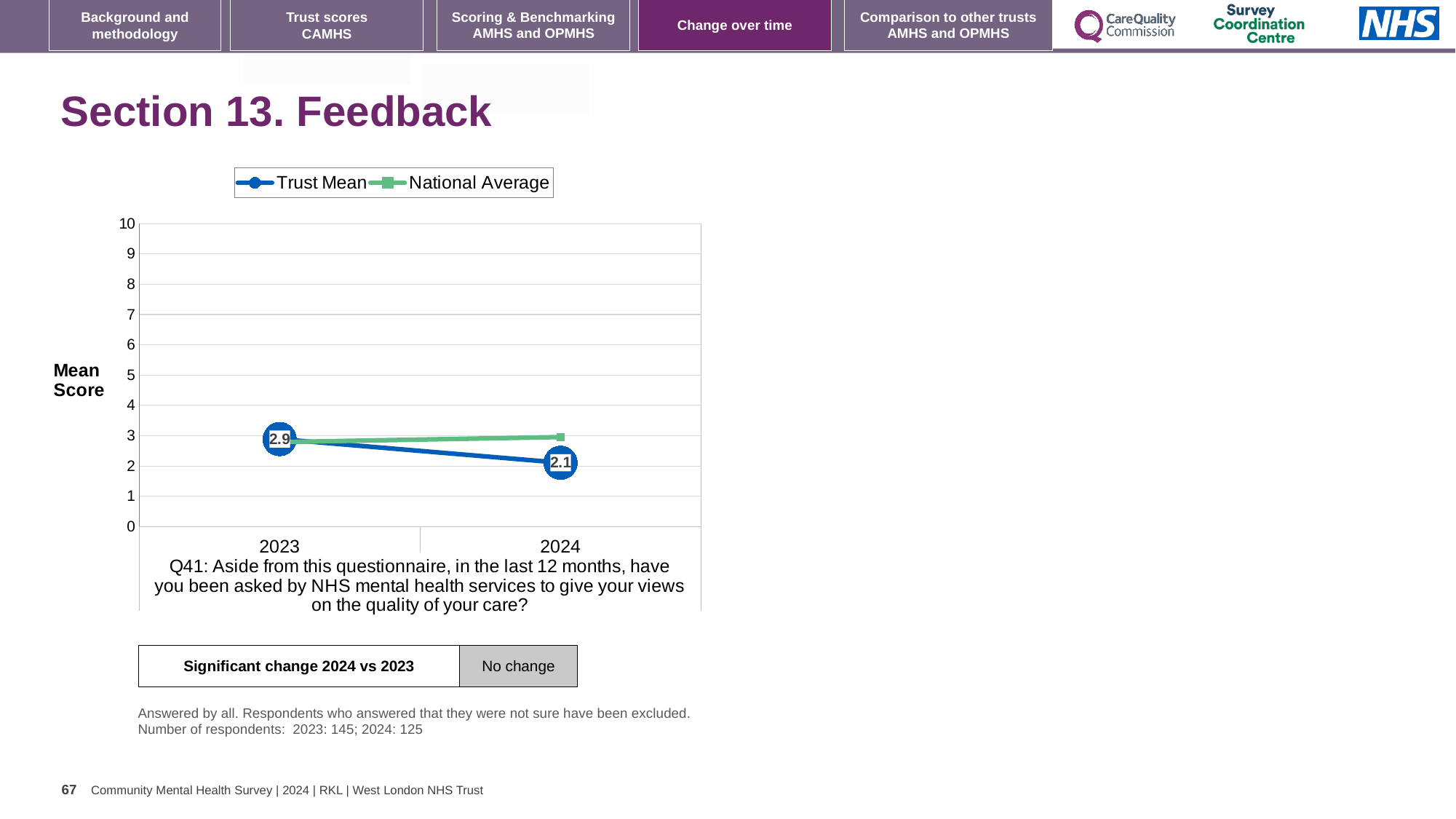
Is the National Average value for 2024 greater or less than 2? greater What is the Trust Mean score for 2023? 2.9 In 2024, which is larger: the Trust Mean or the National Average? National Average How many series does the legend list? 2 What kind of chart is shown on the slide? line chart How many years are plotted on the x axis? 2 In which year is the Trust Mean lowest? 2024 Is the National Average value for 2023 greater or less than 4? less What is the difference between the Trust Mean in 2023 and in 2024? 0.8 In which year is the Trust Mean highest? 2023 Does the Trust Mean rise or fall from 2023 to 2024? fall What is the Trust Mean score for 2024? 2.1